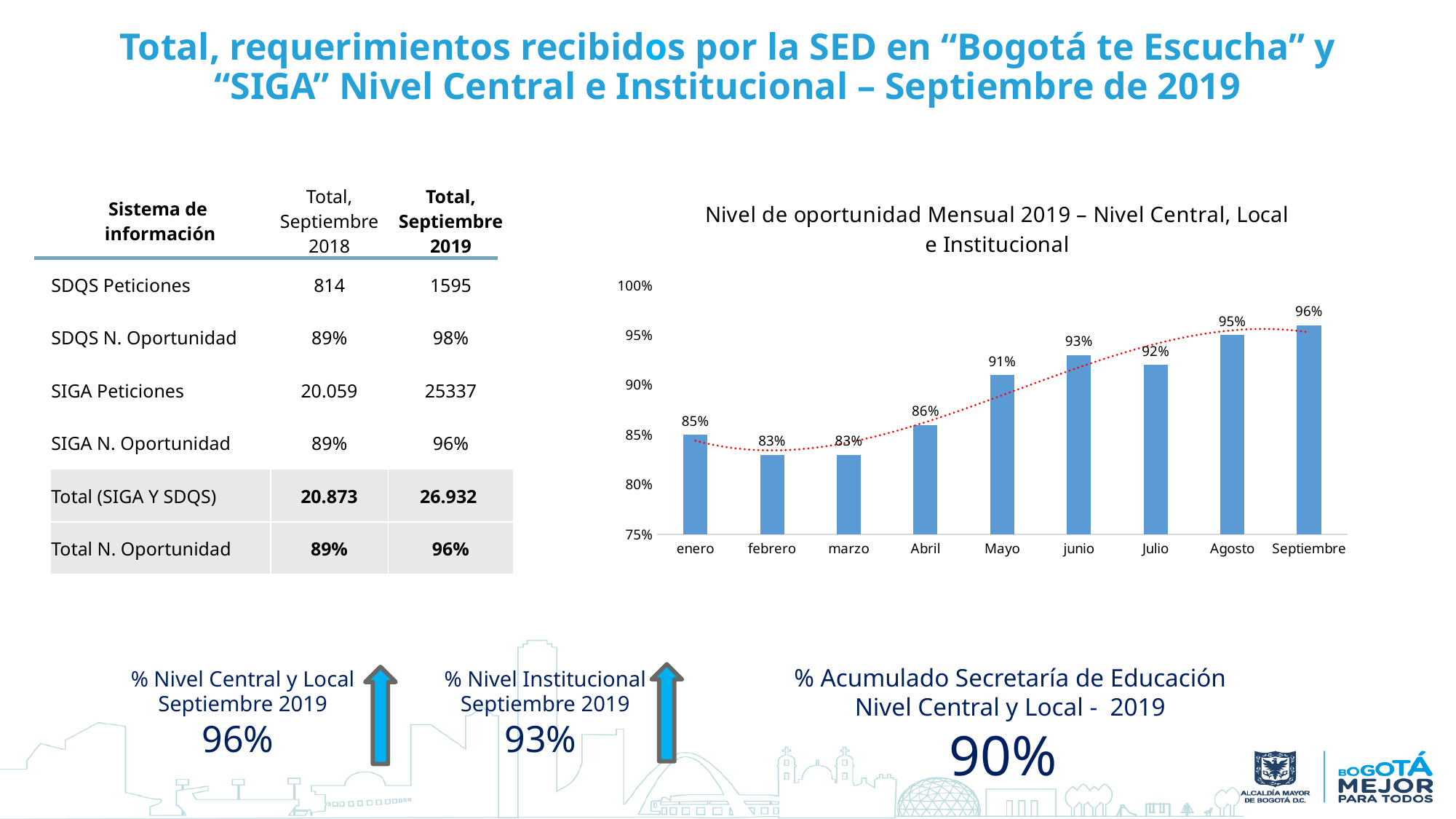
How many months are plotted in the chart? 9 What is the value for enero in the chart? 85% What is the value for Julio in the chart? 92% Which month has the highest value in the chart? Septiembre What kind of chart is shown on the slide? bar chart What is the value for Mayo in the chart? 91% Is the value for Abril greater or less than 90%? less What is the difference between the values for junio and Abril? 7% What is the difference between the values for Septiembre and enero? 11% Which is larger, the value for junio or the value for Julio? junio What is the title of the chart? Nivel de oportunidad Mensual 2019 – Nivel Central, Local e Institucional Do the values generally rise or fall from Abril to Septiembre? rise